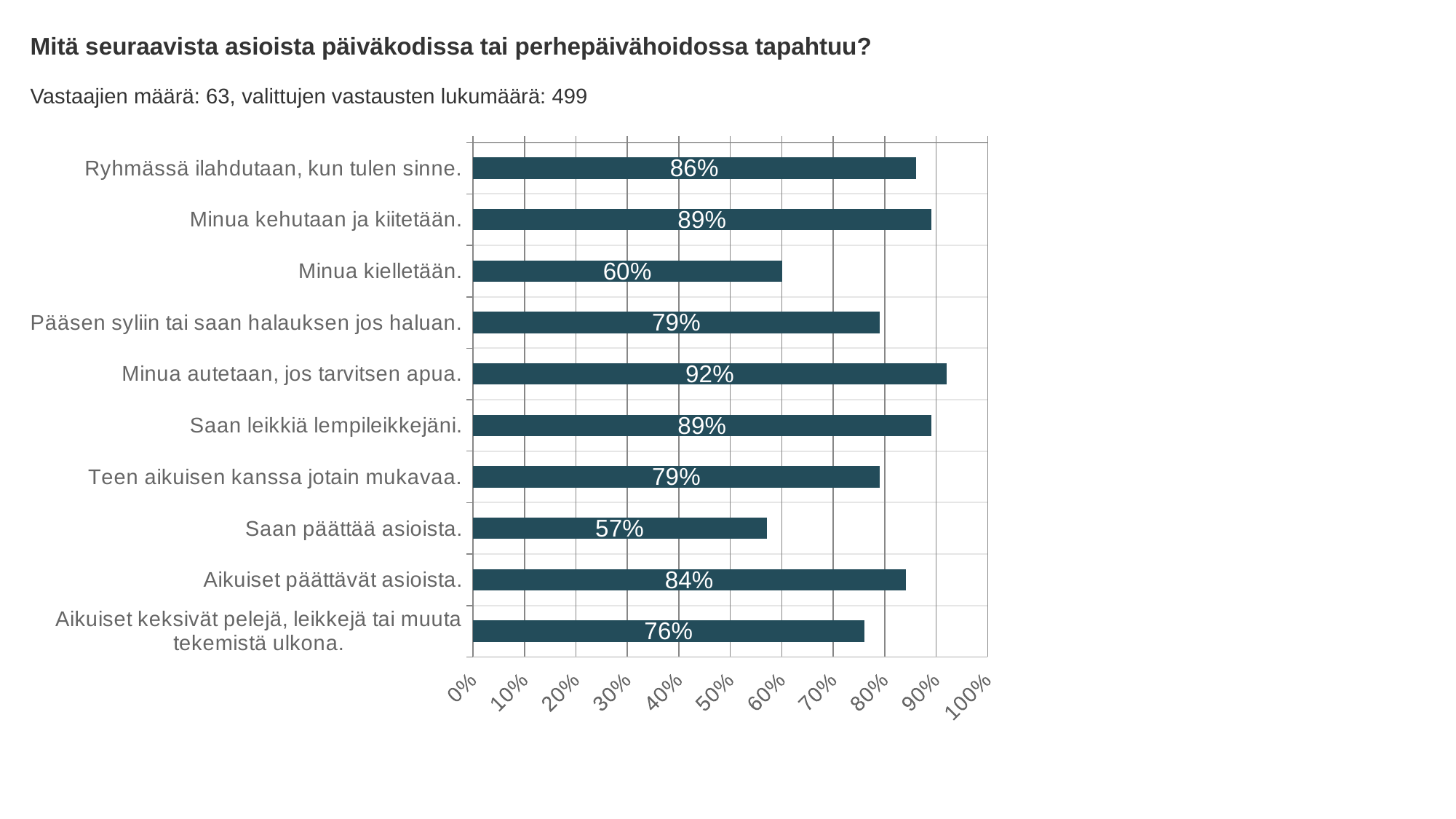
What is the value for "Aikuiset keksivät pelejä, leikkejä tai muuta tekemistä ulkona."? 76% What is the value for "Minua kielletään."? 60% According to the subtitle, how many respondents (vastaajien määrä) were there? 63 Is the value for "Pääsen syliin tai saan halauksen jos haluan." greater or less than 70%? greater Which is larger, the value for "Ryhmässä ilahdutaan, kun tulen sinne." or the value for "Aikuiset päättävät asioista."? Ryhmässä ilahdutaan, kun tulen sinne. Which category has the lowest value? Saan päättää asioista. Which category has the highest value? Minua autetaan, jos tarvitsen apua. What kind of chart is shown on the slide? bar chart What is the difference between the values for "Minua kehutaan ja kiitetään." and "Minua kielletään."? 29% What is the value for "Saan päättää asioista."? 57% How many categories are shown in the chart? 10 What is the value for "Minua autetaan, jos tarvitsen apua."? 92%